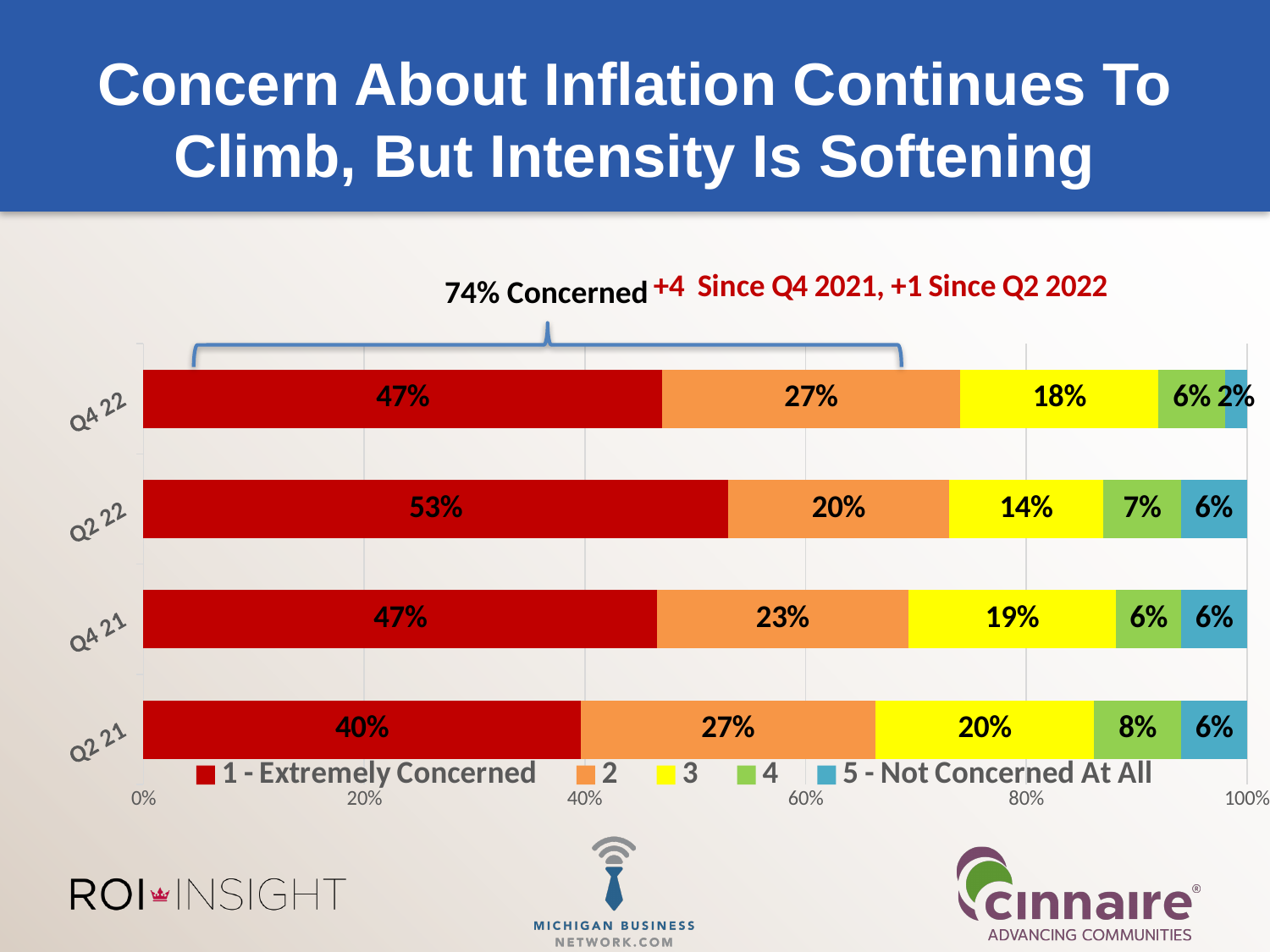
What is the difference between the "1 - Extremely Concerned" values for Q2 22 and Q2 21? 13% What is the value for series "3" in the Q2 22 bar? 14% How many series does the legend list? 5 Which period has the highest share of "1 - Extremely Concerned" respondents? Q2 22 What percentage were "5 - Not Concerned At All" in Q4 22? 2% What is the combined value of the "1 - Extremely Concerned" and "2" segments for Q4 22? 74% How many periods (bars) are shown on the chart? 4 Is the "3" value larger in Q4 21 or in Q2 22? Q4 21 Which period has the lowest share of "1 - Extremely Concerned" respondents? Q2 21 What kind of chart is shown on the slide? Stacked bar chart What is the value for series "2" in the Q2 21 bar? 27% What percentage of respondents were "1 - Extremely Concerned" in Q4 22? 47%